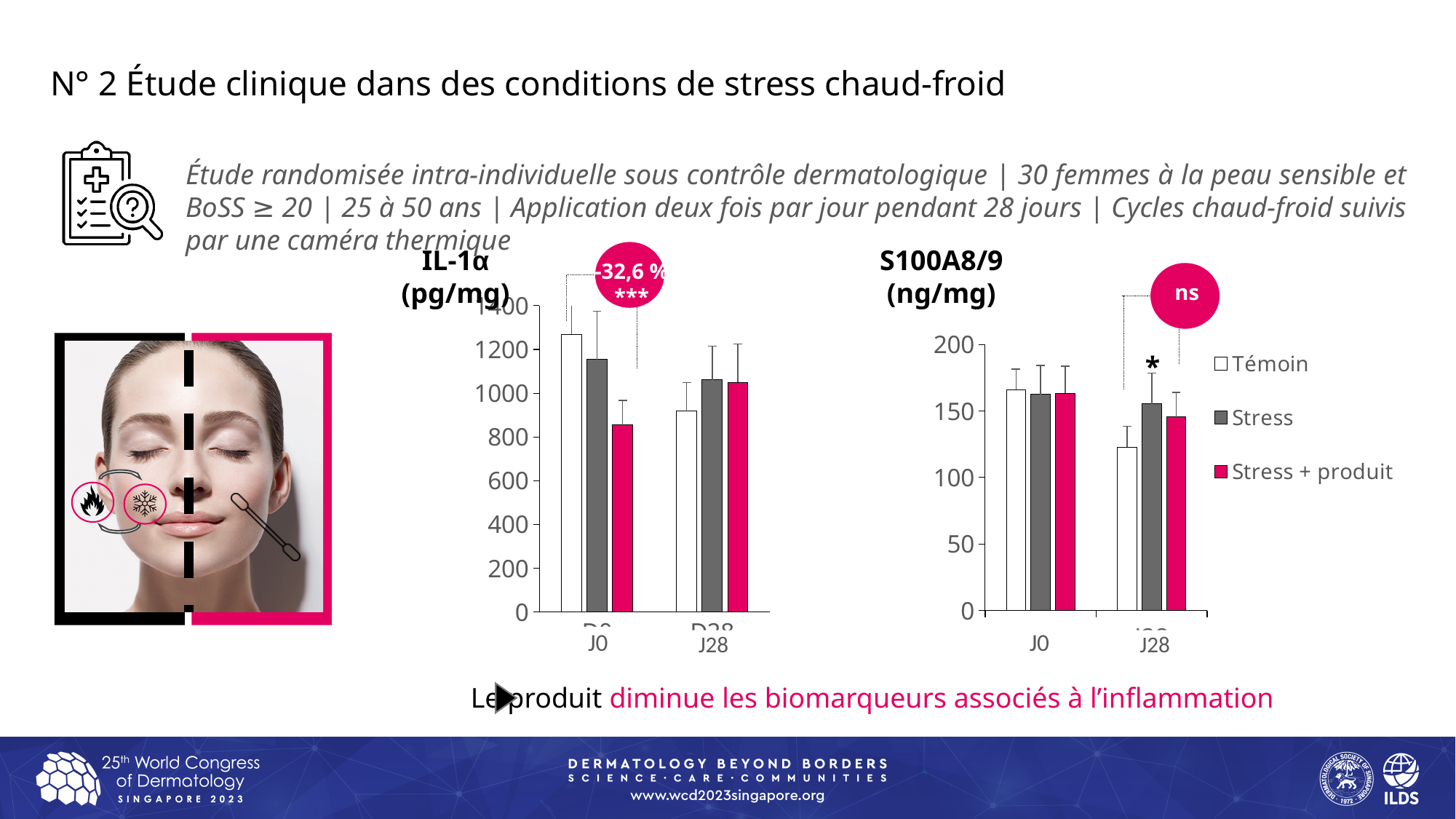
In the IL-1α (pg/mg) chart, does the Témoin value rise or fall from J0 to J28? fall In the IL-1α (pg/mg) chart, which series has the lowest value at J0? Stress + produit How many series does the legend list for the S100A8/9 (ng/mg) chart? 3 In the IL-1α (pg/mg) chart, is the value for Témoin at J0 greater or less than 1200? greater In the IL-1α (pg/mg) chart at J0, which is larger: Témoin or Stress + produit? Témoin What kind of chart is the IL-1α (pg/mg) chart? bar chart In the IL-1α (pg/mg) chart, is the value for Stress + produit at J0 greater or less than 1000? less In the S100A8/9 (ng/mg) chart at J28, which is larger: Témoin or Stress? Stress What percentage change is shown in the annotation bubble on the IL-1α (pg/mg) chart? -32,6 % In the S100A8/9 (ng/mg) chart, is the value for Témoin at J0 greater or less than 150? greater How many time-point categories are shown on the x axis of the IL-1α (pg/mg) chart? 2